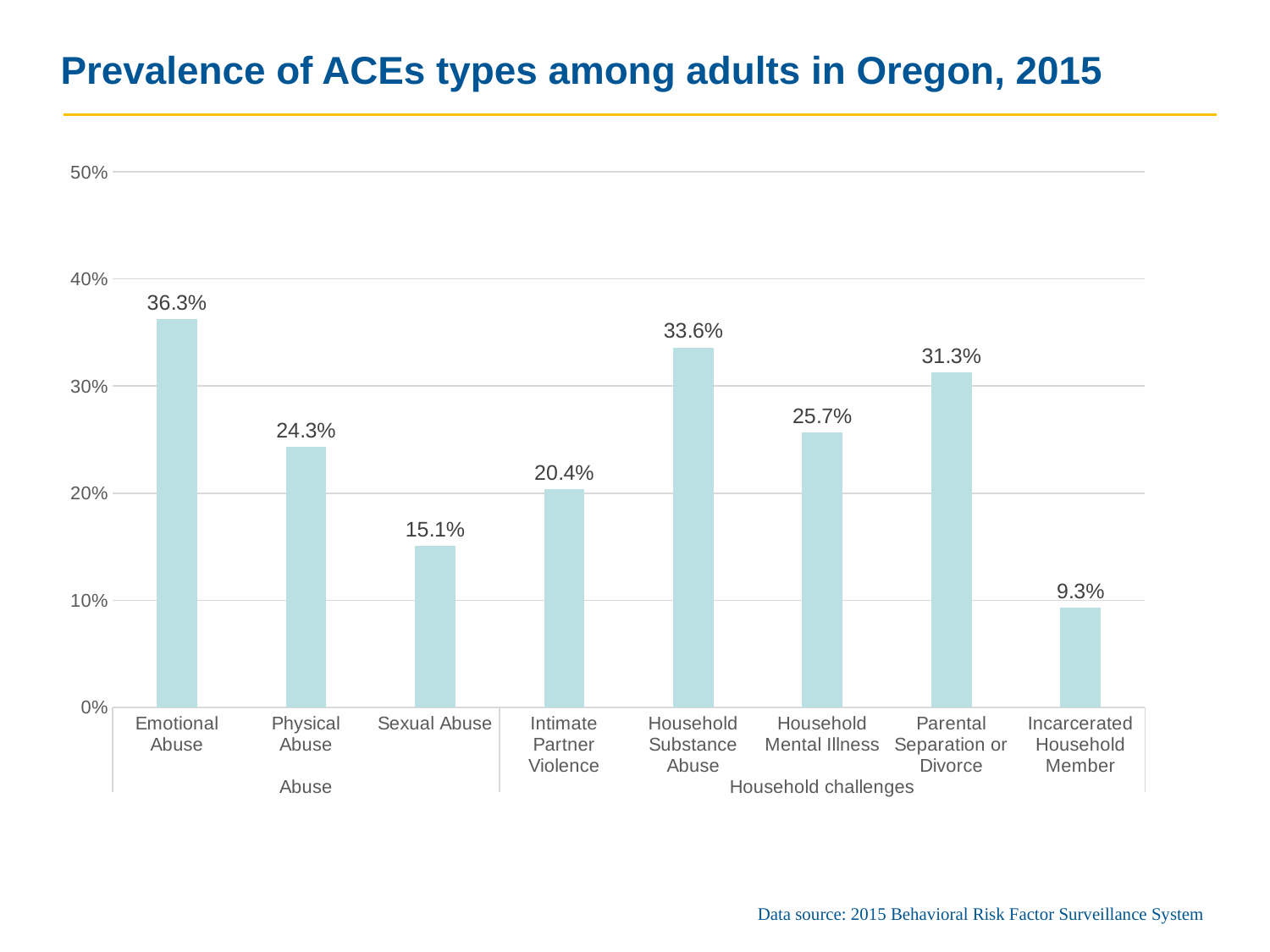
How many ACE types are shown in the chart? 8 Which ACE type has the lowest prevalence? Incarcerated Household Member What is the title of the chart? Prevalence of ACEs types among adults in Oregon, 2015 What are the two groups the categories are divided into on the x axis? Abuse and Household challenges What is the prevalence of Incarcerated Household Member? 9.3% Is the value for Parental Separation or Divorce greater or less than 30%? greater What kind of chart is shown on the slide? Bar chart What is the prevalence of Emotional Abuse? 36.3% What is the difference between the prevalence of Physical Abuse and Sexual Abuse? 9.2% Which is larger, the prevalence of Household Mental Illness or Intimate Partner Violence? Household Mental Illness Which ACE type has the highest prevalence? Emotional Abuse What is the prevalence of Household Substance Abuse? 33.6%